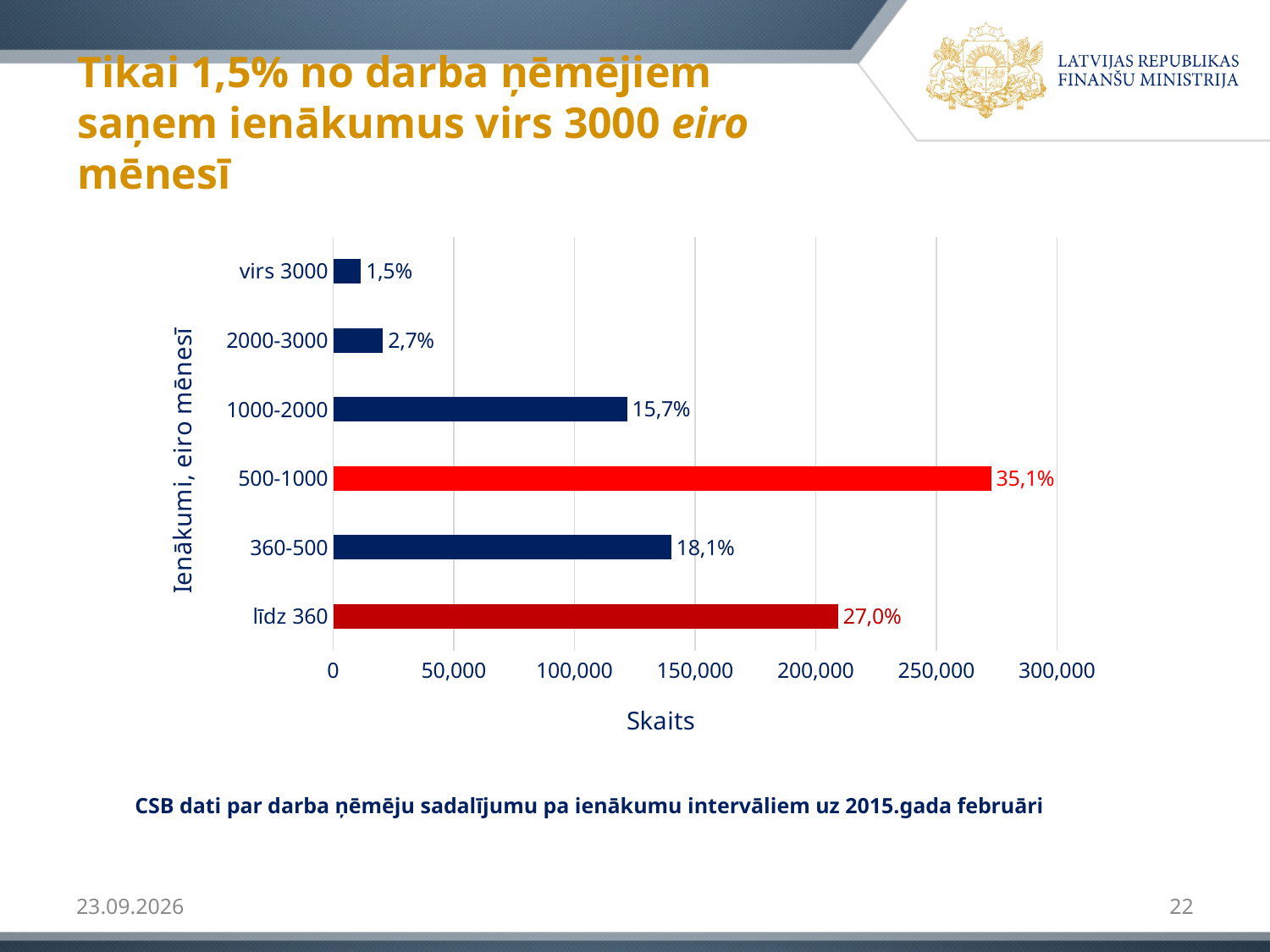
What is the title of the horizontal axis? Skaits What data label is shown for the 500-1000 income bar? 35,1% Which bar is longer: 360-500 or 1000-2000? 360-500 What data label is shown for the līdz 360 income bar? 27,0% Which income interval has the shortest bar? virs 3000 Is the count (Skaits) for the līdz 360 bar greater or less than 200,000? greater Which income interval has the longest bar? 500-1000 What is the difference in percentage points between the labels for 360-500 and 2000-3000? 15,4 What data label is shown for the virs 3000 income bar? 1,5% How many income intervals are shown on the chart? 6 What kind of chart is shown on the slide? bar chart What data label is shown for the 1000-2000 income bar? 15,7%